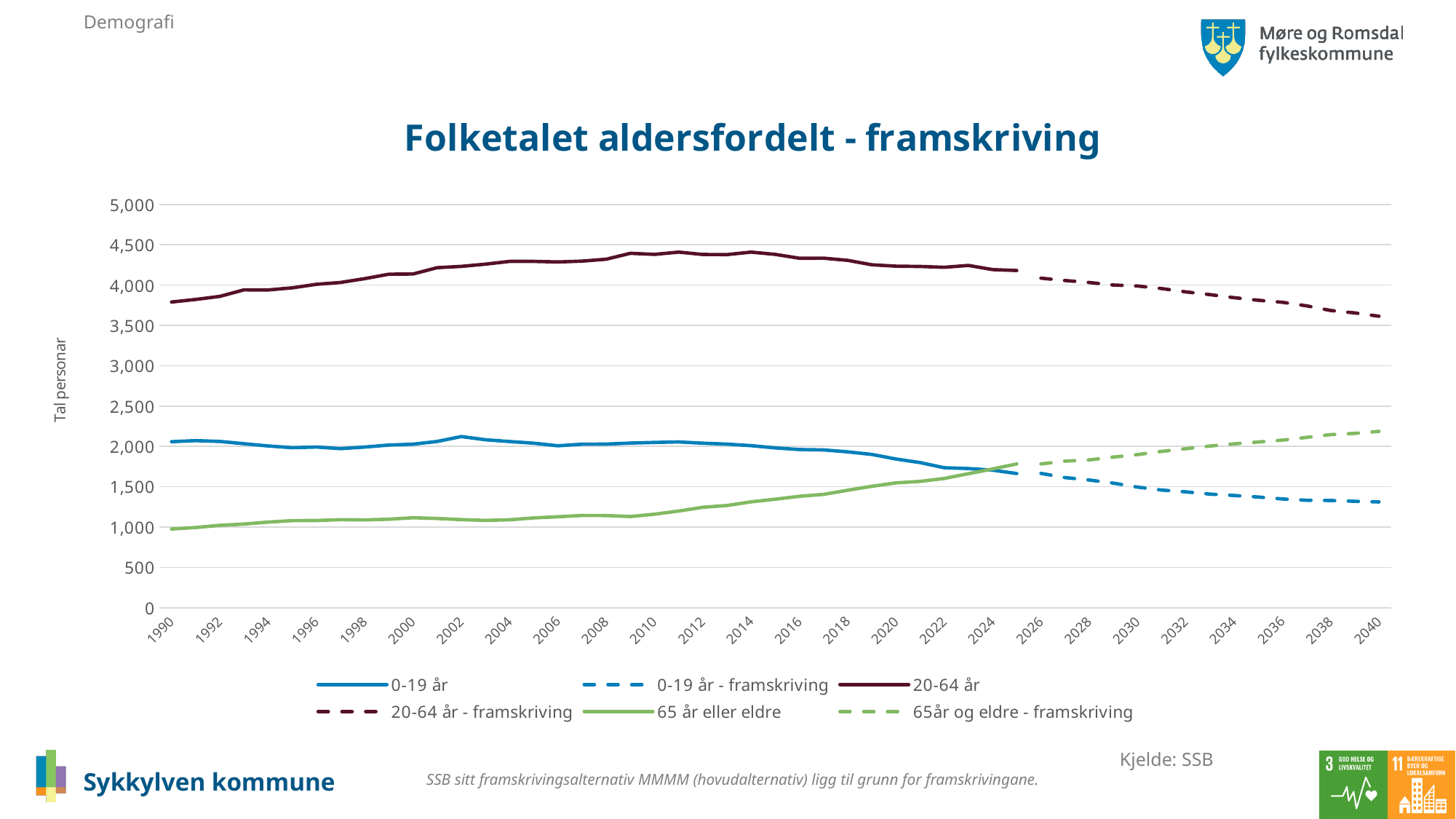
Is the value for 65 år eller eldre in 1990 greater or less than 1,500? less Which series has the highest values across the whole chart? 20-64 år How many series does the legend list? 6 What kind of chart is shown on the slide? line chart Is the value for 20-64 år in 1990 greater or less than 3,500? greater Is the value for 20-64 år - framskriving in 2040 greater or less than 4,000? less What is the title of the chart? Folketalet aldersfordelt - framskriving Does the 20-64 år - framskriving series rise or fall from 2026 to 2040? fall In 2040, which is higher: 0-19 år - framskriving or 65år og eldre - framskriving? 65år og eldre - framskriving What is the label on the vertical axis? Tal personar